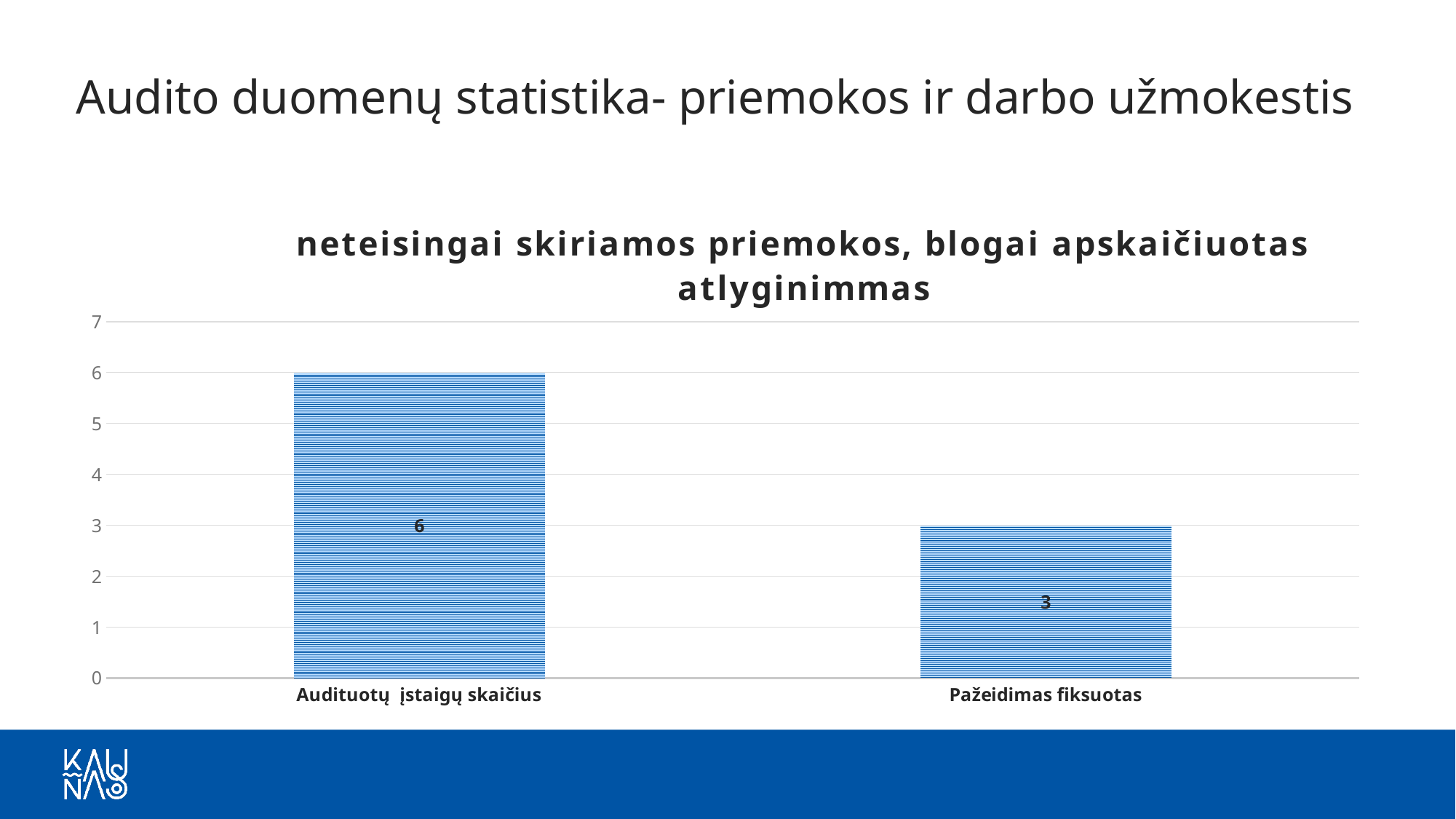
Is the value for Audituotų įstaigų skaičius greater or less than 4? greater What is the value for Audituotų įstaigų skaičius? 6 Which category has the highest value? Audituotų įstaigų skaičius Which category has the lowest value? Pažeidimas fiksuotas What is the title of the chart? neteisingai skiriamos priemokos, blogai apskaičiuotas atlyginimmas Is the value for Pažeidimas fiksuotas greater or less than 5? less Which is larger, the value for Audituotų įstaigų skaičius or the value for Pažeidimas fiksuotas? Audituotų įstaigų skaičius How many categories are shown on the x axis? 2 What is the value for Pažeidimas fiksuotas? 3 What kind of chart is shown on the slide? bar chart What is the difference between the values for Audituotų įstaigų skaičius and Pažeidimas fiksuotas? 3 What is the highest value shown on the vertical axis? 7